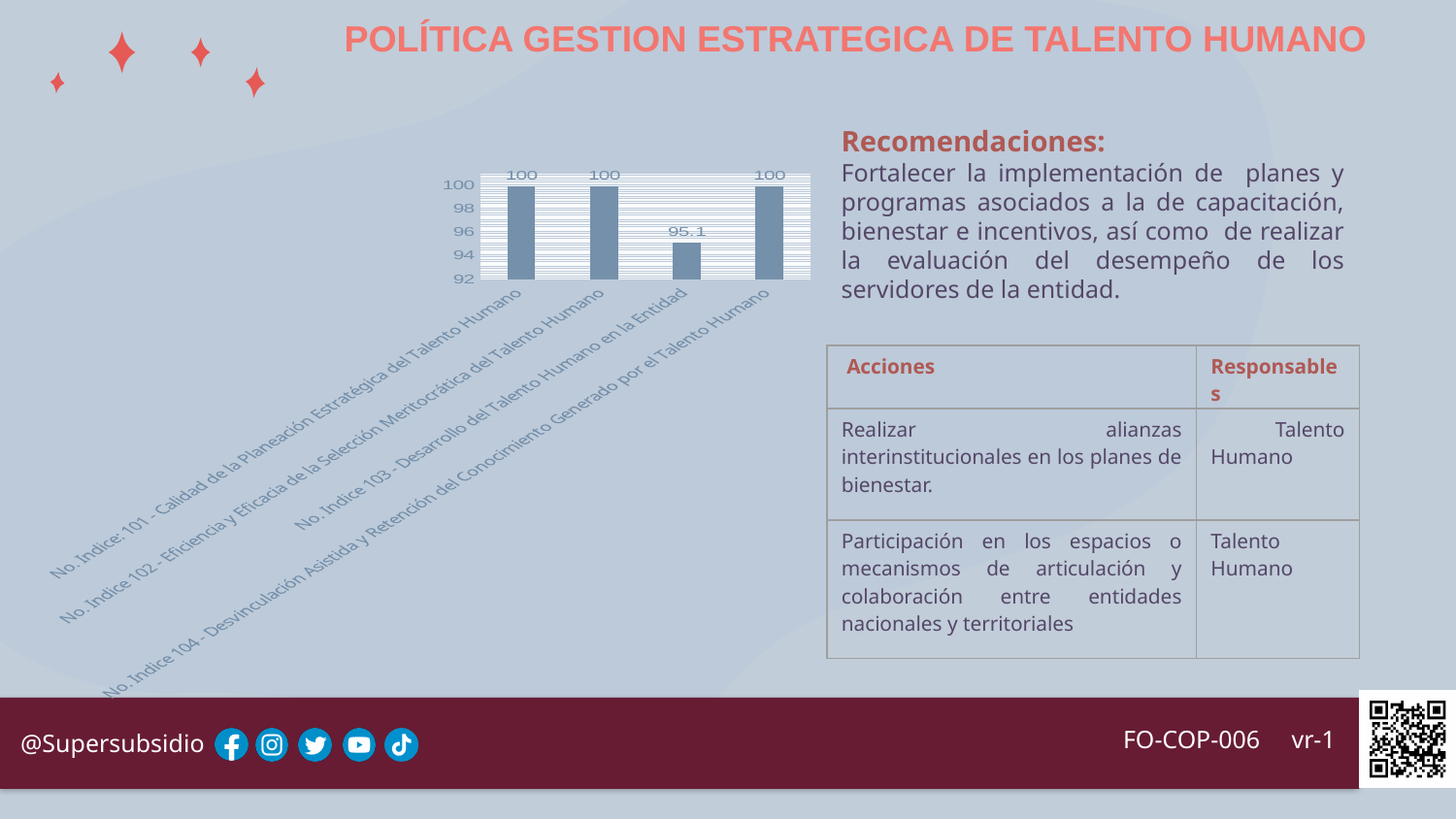
What kind of chart is shown on the slide? bar chart Which category has the lowest value in the chart? No. Indice 103 - Desarrollo del Talento Humano en la Entidad What is the difference between the value for No. Indice 102 and the value for No. Indice 103? 4.9 What is the highest tick value shown on the vertical axis of the chart? 100 What is the lowest tick value shown on the vertical axis of the chart? 92 What is the value for No. Indice 103 - Desarrollo del Talento Humano en la Entidad? 95.1 How many categories (bars) are shown in the chart? 4 Is the value for No. Indice 103 greater or less than 96? less How many bars in the chart have a value of 100? 3 What is the value for No. Indice 104 - Desvinculación Asistida y Retención del Conocimiento Generado por el Talento Humano? 100 What is the value for No. Indice: 101 - Calidad de la Planeación Estratégica del Talento Humano? 100 Which is larger, the value for No. Indice 101 or the value for No. Indice 103? No. Indice 101